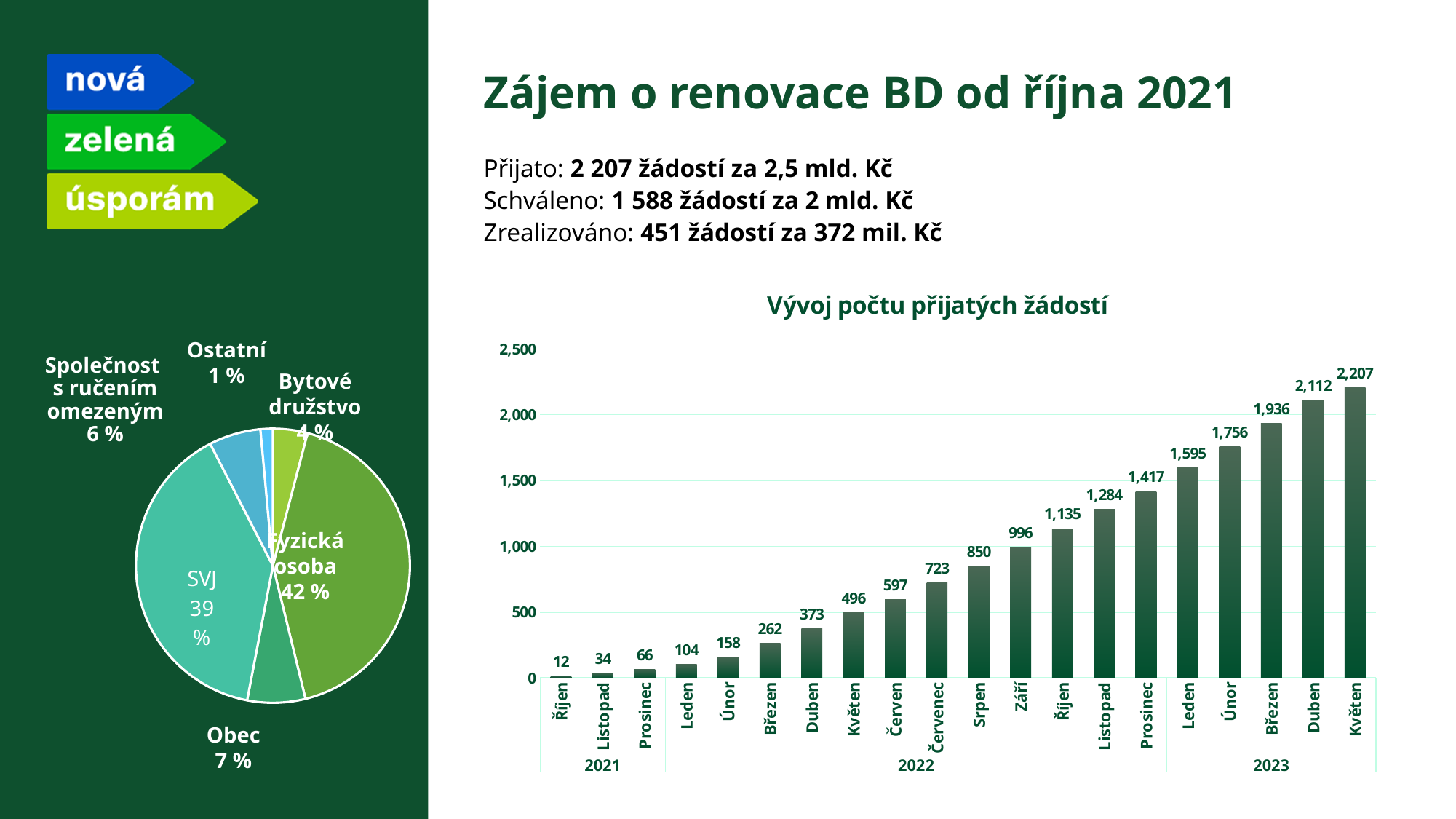
In the bar chart 'Vývoj počtu přijatých žádostí', which month has the highest value? Květen 2023 In the bar chart 'Vývoj počtu přijatých žádostí', what is the value for Květen 2023? 2,207 In the bar chart 'Vývoj počtu přijatých žádostí', what is the difference between the values for Duben 2023 and Březen 2023? 176 In the bar chart 'Vývoj počtu přijatých žádostí', do the values rise or fall from left to right? rise In the pie chart on the left of the slide, which is larger: Obec or Bytové družstvo? Obec In the bar chart 'Vývoj počtu přijatých žádostí', how many bars are plotted? 20 What kind of chart is 'Vývoj počtu přijatých žádostí'? bar chart In the bar chart 'Vývoj počtu přijatých žádostí', what is the value for Srpen 2022? 850 In the pie chart on the left of the slide, what share does SVJ have? 39 % In the bar chart 'Vývoj počtu přijatých žádostí', which month has the lowest value? Říjen 2021 In the pie chart on the left of the slide, how many slices are there? 6 In the pie chart on the left of the slide, which category has the largest share? Fyzická osoba